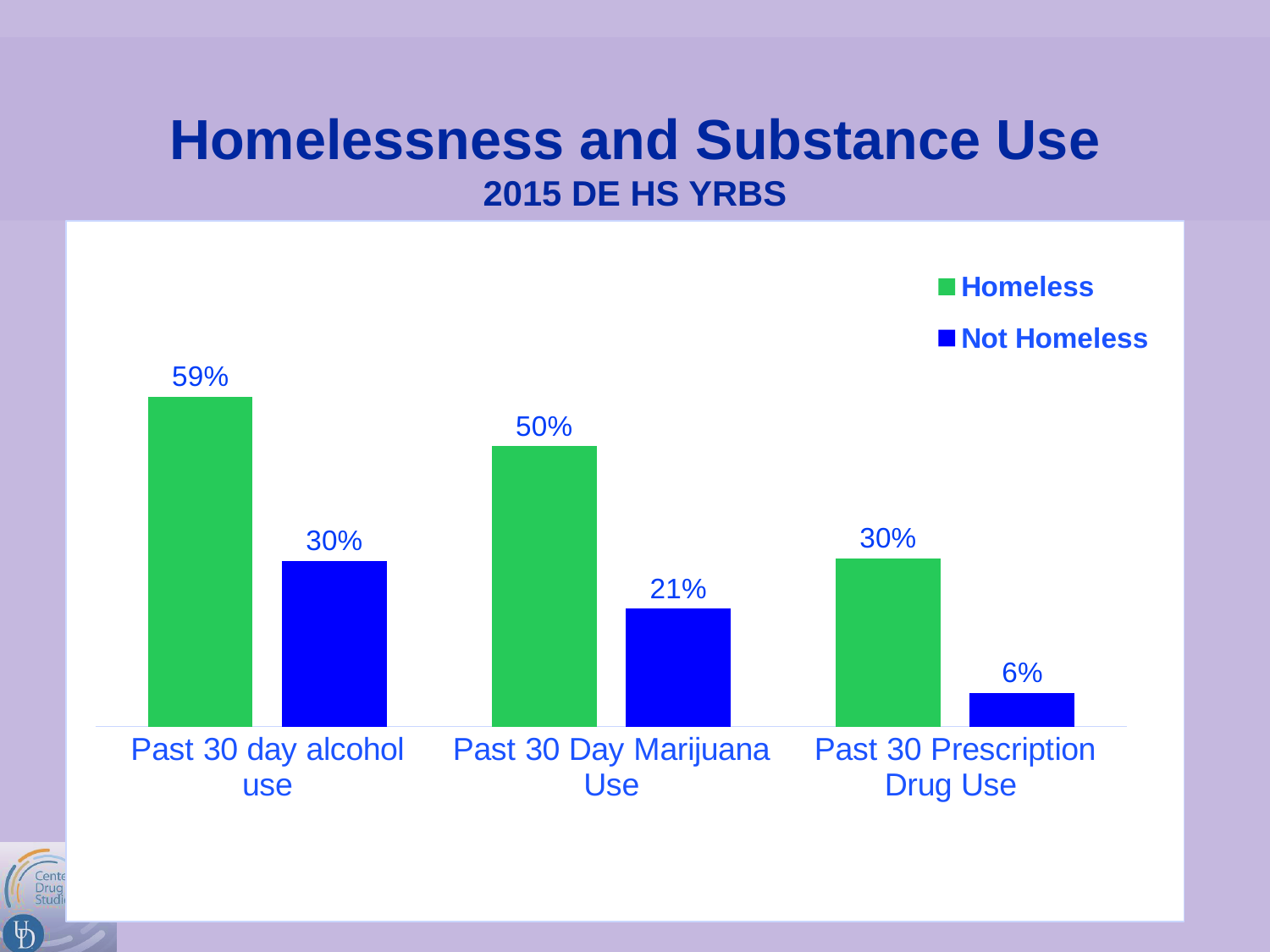
What is the difference between the Homeless and Not Homeless values for Past 30 day alcohol use? 29% Which is larger for Past 30 Prescription Drug Use: the Homeless value or the Not Homeless value? Homeless What is the difference between the Homeless and Not Homeless values for Past 30 Day Marijuana Use? 29% Which category has the lowest Not Homeless value? Past 30 Prescription Drug Use What is the value for Homeless for Past 30 day alcohol use? 59% What is the value for Not Homeless for Past 30 Day Marijuana Use? 21% What is the value for Not Homeless for Past 30 Prescription Drug Use? 6% What kind of chart is shown on the slide? Bar chart How many series does the legend list? 2 How many categories are shown on the x axis? 3 Which category has the highest Homeless value? Past 30 day alcohol use What is the value for Homeless for Past 30 Prescription Drug Use? 30%